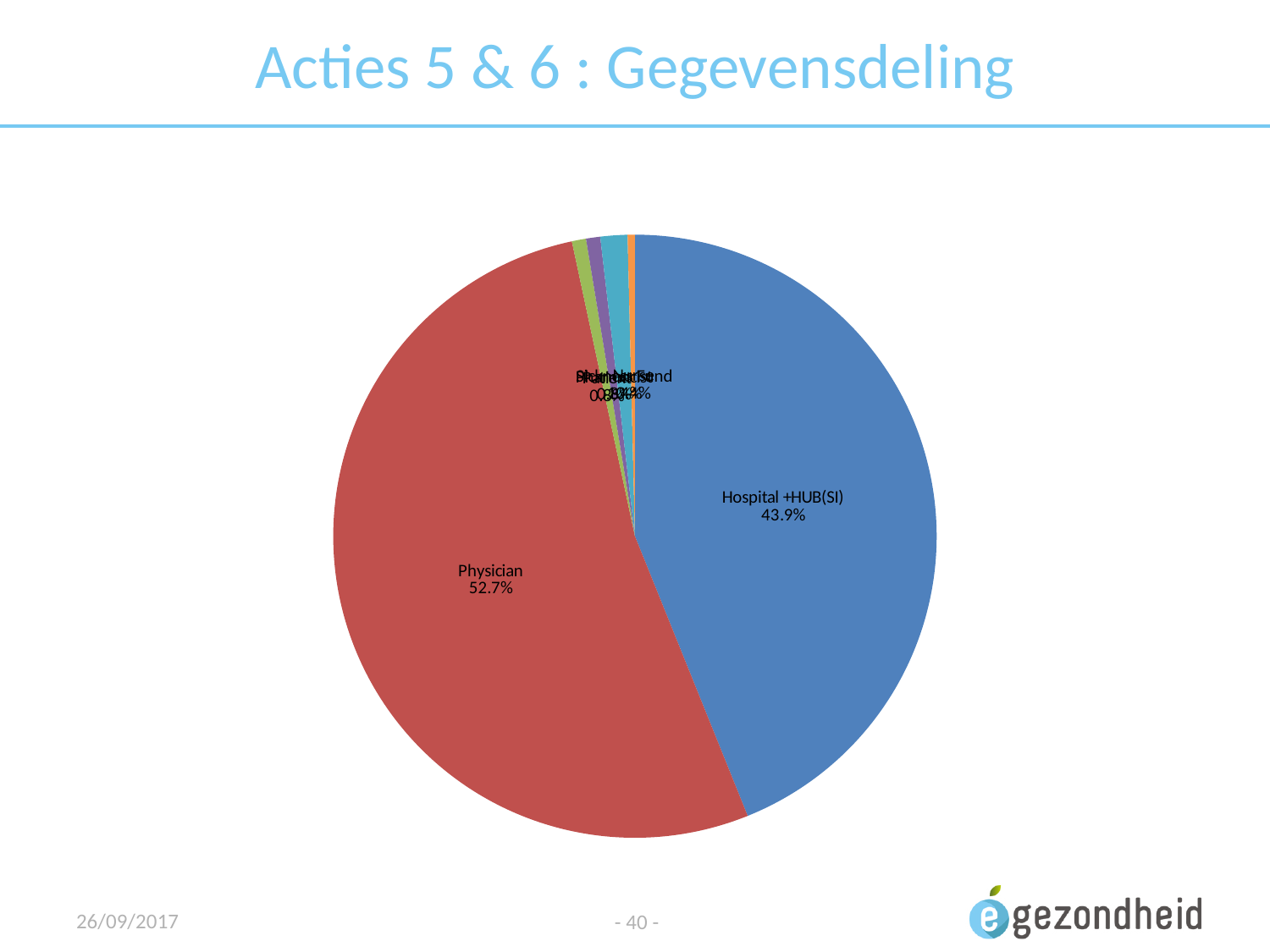
What is the difference in percentage points between the Physician share and the Hospital +HUB(SI) share? 8.8 percentage points What share of the pie does the Hospital +HUB(SI) slice represent? 43.9% What is the title of the slide containing the pie chart? Acties 5 & 6 : Gegevensdeling What share of the pie does the Physician slice represent? 52.7% Which is larger, the Physician slice or the Hospital +HUB(SI) slice? Physician Which category has the largest slice of the pie? Physician Is the Hospital +HUB(SI) share greater or less than 50%? less What is the combined share of the Physician and Hospital +HUB(SI) slices? 96.6% What kind of chart is shown on the slide? Pie chart What colour is the Physician slice of the pie chart? Red Is the Physician share greater or less than 50%? greater